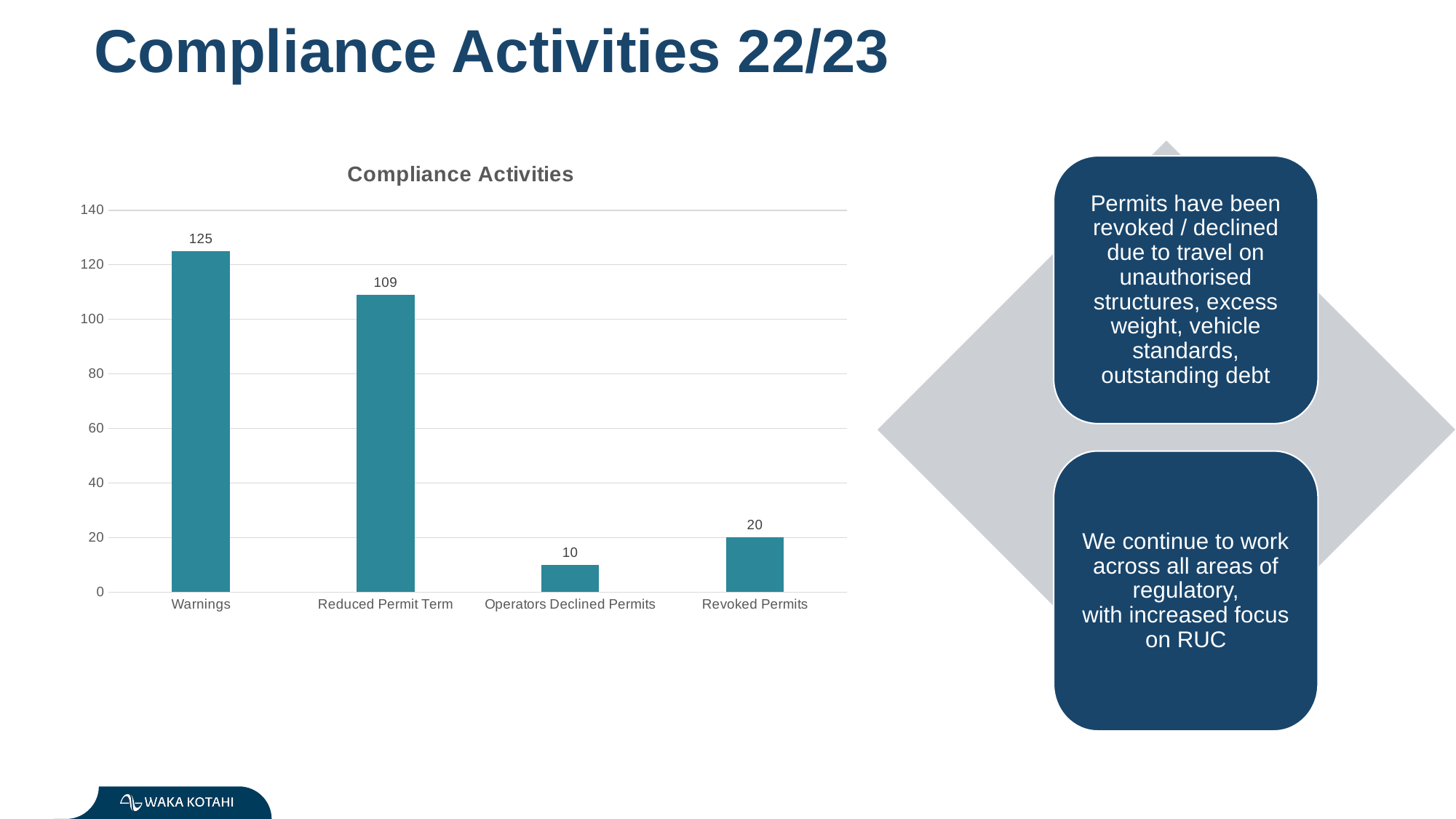
What is the title of the chart? Compliance Activities Which is larger, the value for Revoked Permits or the value for Operators Declined Permits? Revoked Permits How many categories are shown on the x axis? 4 Which category has the lowest value? Operators Declined Permits What is the value for Revoked Permits? 20 What is the difference between the values for Warnings and Reduced Permit Term? 16 What is the value for Reduced Permit Term? 109 Which category has the highest value? Warnings What kind of chart is shown on the slide? Bar chart What is the difference between the values for Revoked Permits and Operators Declined Permits? 10 What is the value for Operators Declined Permits? 10 What is the value for Warnings? 125